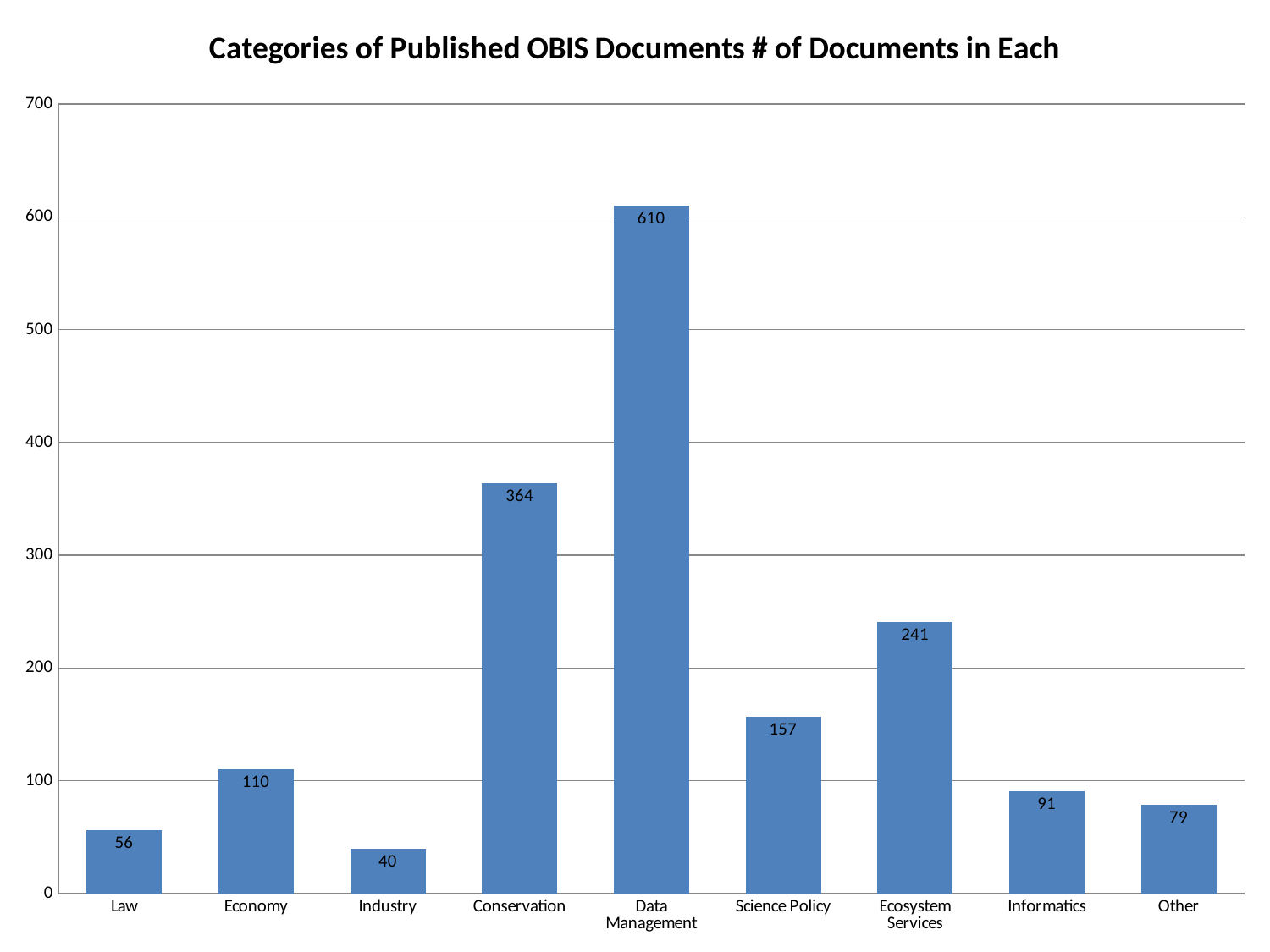
Which category has the lowest number of documents? Industry Is the value for Conservation greater or less than 300? greater What kind of chart is shown on the slide? Bar chart How many documents are in the Data Management category? 610 What is the difference between the Economy and Law values? 54 What is the difference between the Data Management and Conservation values? 246 How many categories are shown on the x axis? 9 What is the title of the chart? Categories of Published OBIS Documents # of Documents in Each How many documents are in the Industry category? 40 Which category has the highest number of documents? Data Management What is the value for Ecosystem Services? 241 Which is larger, Science Policy or Informatics? Science Policy